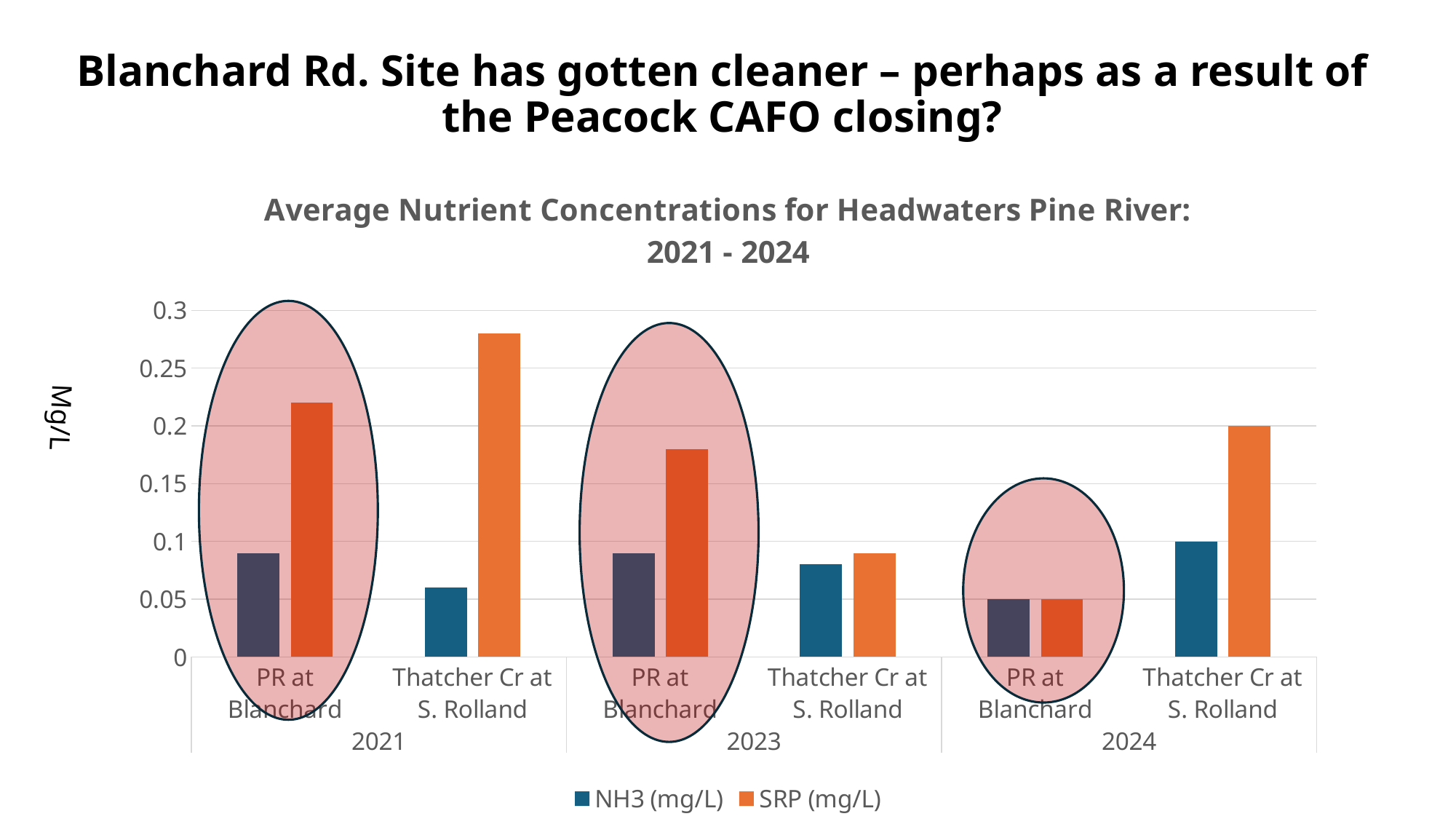
What are the two series named in the legend? NH3 (mg/L) and SRP (mg/L) Does the SRP (mg/L) value for PR at Blanchard rise or fall from 2021 to 2024? fall How many years are shown along the x axis? 3 Is the SRP (mg/L) value for PR at Blanchard in 2023 greater or less than 0.2? less What is the label on the vertical axis? Mg/L What kind of chart is shown on the slide? bar chart How many series does the legend list? 2 Which site and year has the highest SRP (mg/L) bar? Thatcher Cr at S. Rolland, 2021 Is the SRP (mg/L) value for Thatcher Cr at S. Rolland in 2021 greater or less than 0.25? greater What is the NH3 (mg/L) value for Thatcher Cr at S. Rolland in 2024? 0.1 What is the SRP (mg/L) value for Thatcher Cr at S. Rolland in 2024? 0.2 What is the SRP (mg/L) value for PR at Blanchard in 2024? 0.05